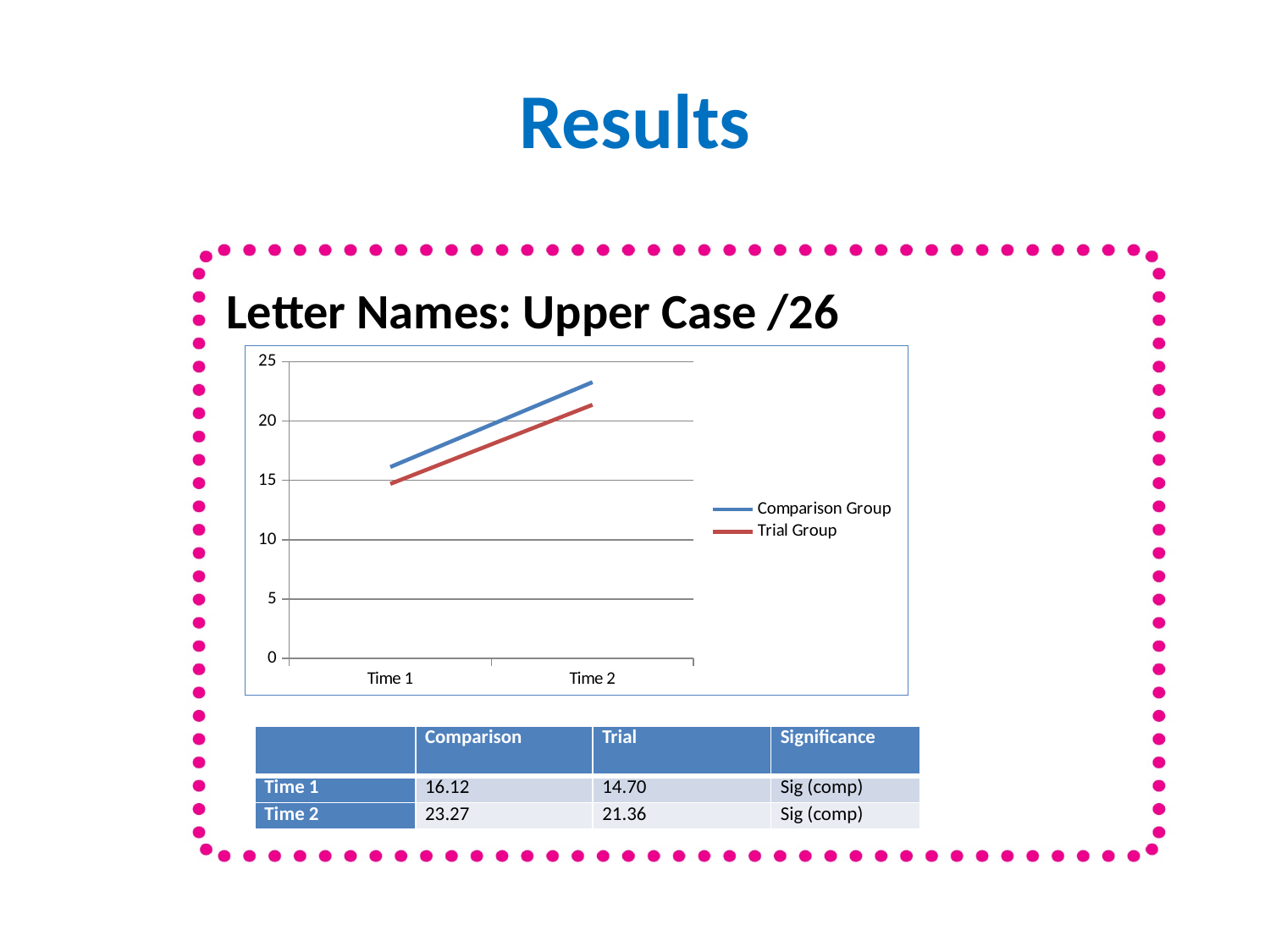
Is the value for the Trial Group at Time 2 greater or less than 20? greater By how much does the Comparison Group's value increase from Time 1 to Time 2? 7.15 What is the value for the Trial Group at Time 1? 14.70 What is the value for the Trial Group at Time 2? 21.36 Do the values for the Trial Group rise or fall from Time 1 to Time 2? rise What is the value for the Comparison Group at Time 1? 16.12 How many time points are plotted on the x axis of the chart? 2 What is the difference between the Comparison Group and the Trial Group at Time 1? 1.42 What kind of chart is shown on the slide? line chart Which group has the higher value at Time 2? Comparison Group How many series does the chart legend list? 2 What colour is the line for the Trial Group? red